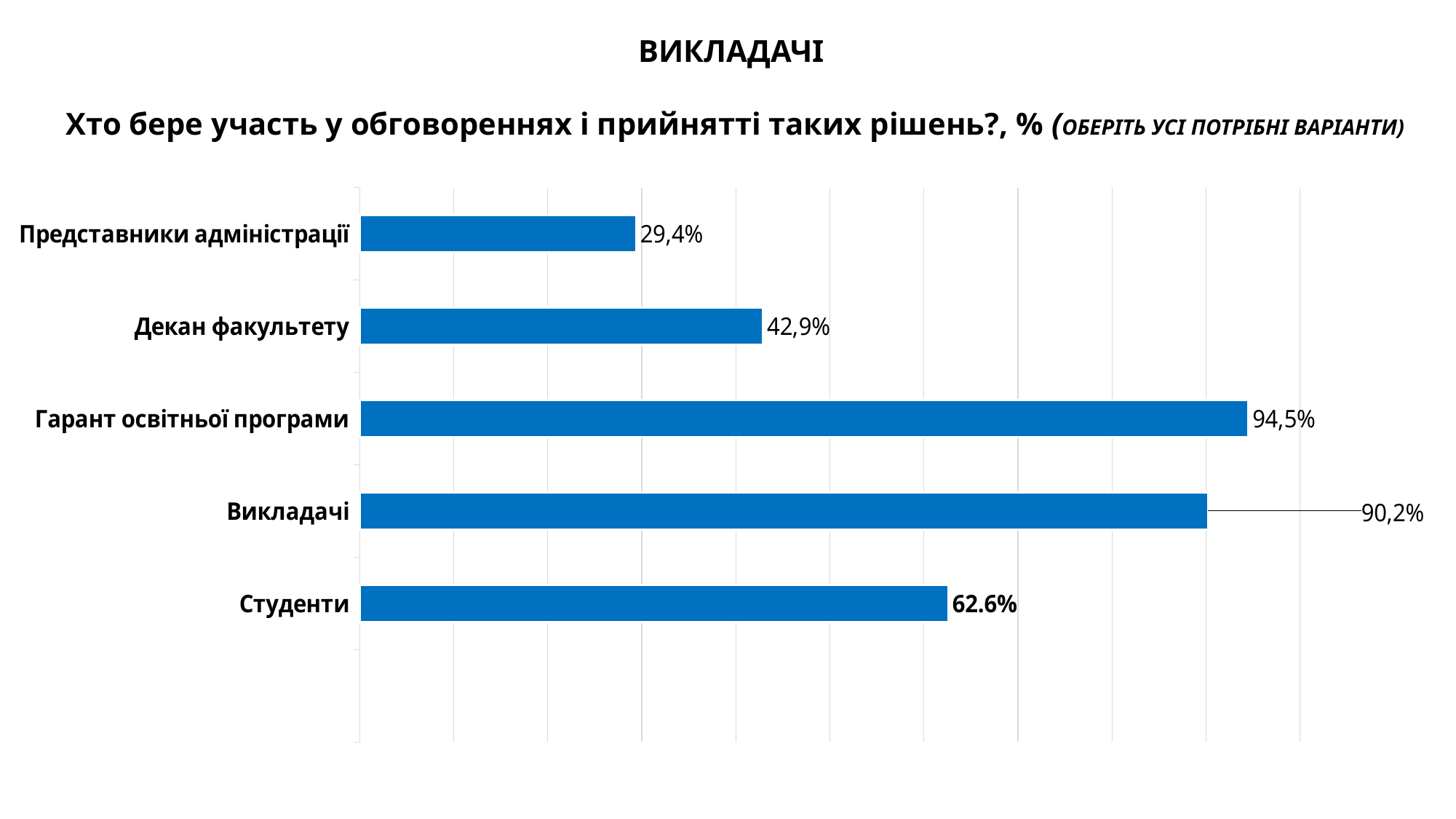
What value is shown for Гарант освітньої програми? 94,5% What is the difference between the values for Гарант освітньої програми and Викладачі? 4,3% What value is shown for Декан факультету? 42,9% What value is shown for Студенти? 62.6% What is the heading at the top of the slide? ВИКЛАДАЧІ Which is larger, the value for Викладачі or the value for Студенти? Викладачі Which category has the highest value? Гарант освітньої програми How many categories are shown in the chart? 5 What kind of chart is shown on the slide? Bar chart What is the difference between the values for Декан факультету and Представники адміністрації? 13,5% Which category has the lowest value? Представники адміністрації What value is shown for Представники адміністрації? 29,4%